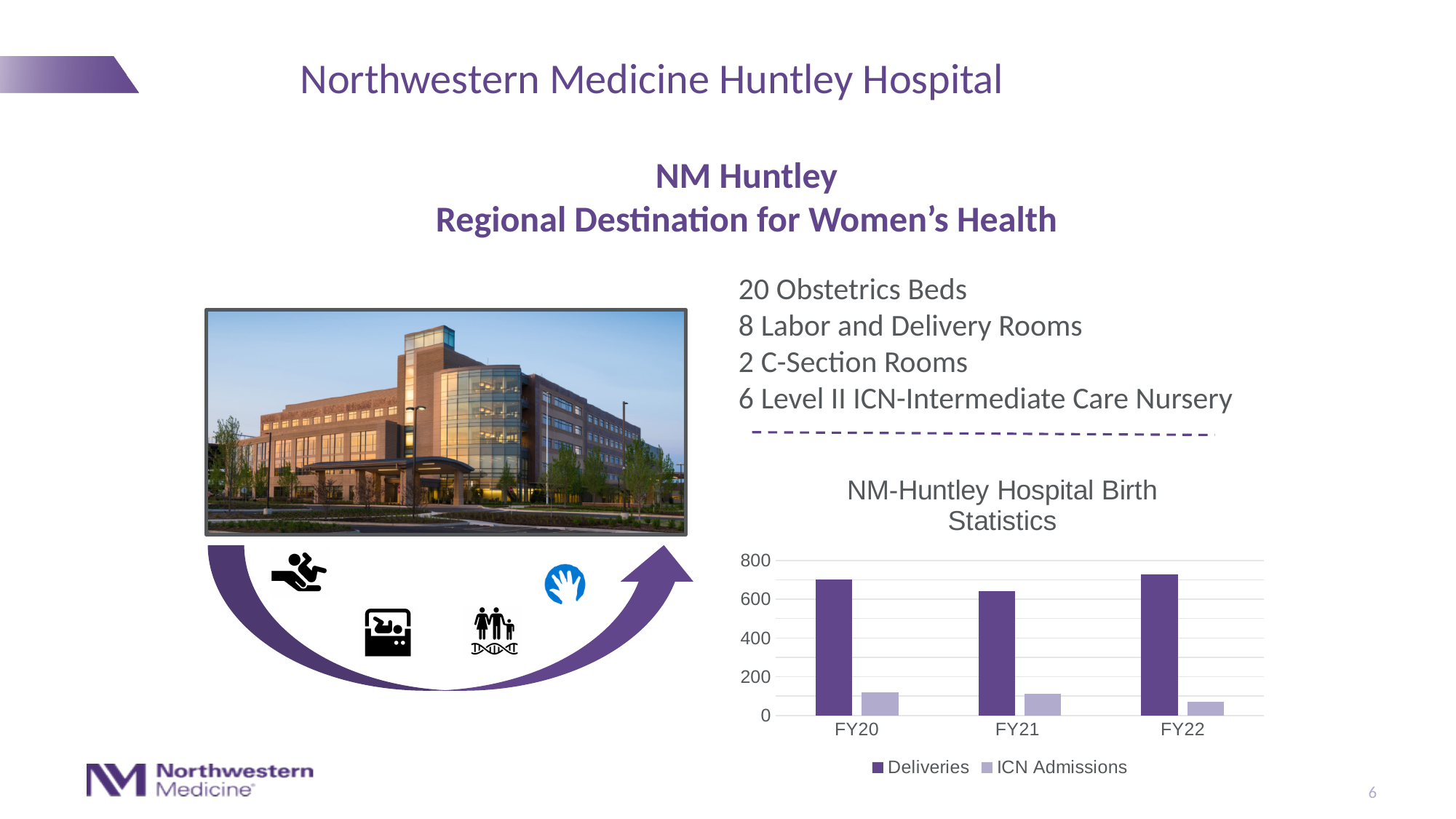
What is the title of the chart on the slide? NM-Huntley Hospital Birth Statistics Which fiscal year has the lowest number of Deliveries in the NM-Huntley Hospital Birth Statistics chart? FY21 Which is larger in the NM-Huntley Hospital Birth Statistics chart: Deliveries in FY21 or Deliveries in FY22? Deliveries in FY22 Which fiscal year has the lowest number of ICN Admissions in the NM-Huntley Hospital Birth Statistics chart? FY22 How many series does the legend of the NM-Huntley Hospital Birth Statistics chart list? 2 What kind of chart is the NM-Huntley Hospital Birth Statistics chart? bar chart Is the value for ICN Admissions in FY22 greater or less than 100? less Is the value for Deliveries in FY20 greater or less than 600? greater Is the value for ICN Admissions in FY20 greater or less than 200? less Do ICN Admissions rise or fall from FY20 to FY22 in the NM-Huntley Hospital Birth Statistics chart? fall How many fiscal years are shown on the x axis of the NM-Huntley Hospital Birth Statistics chart? 3